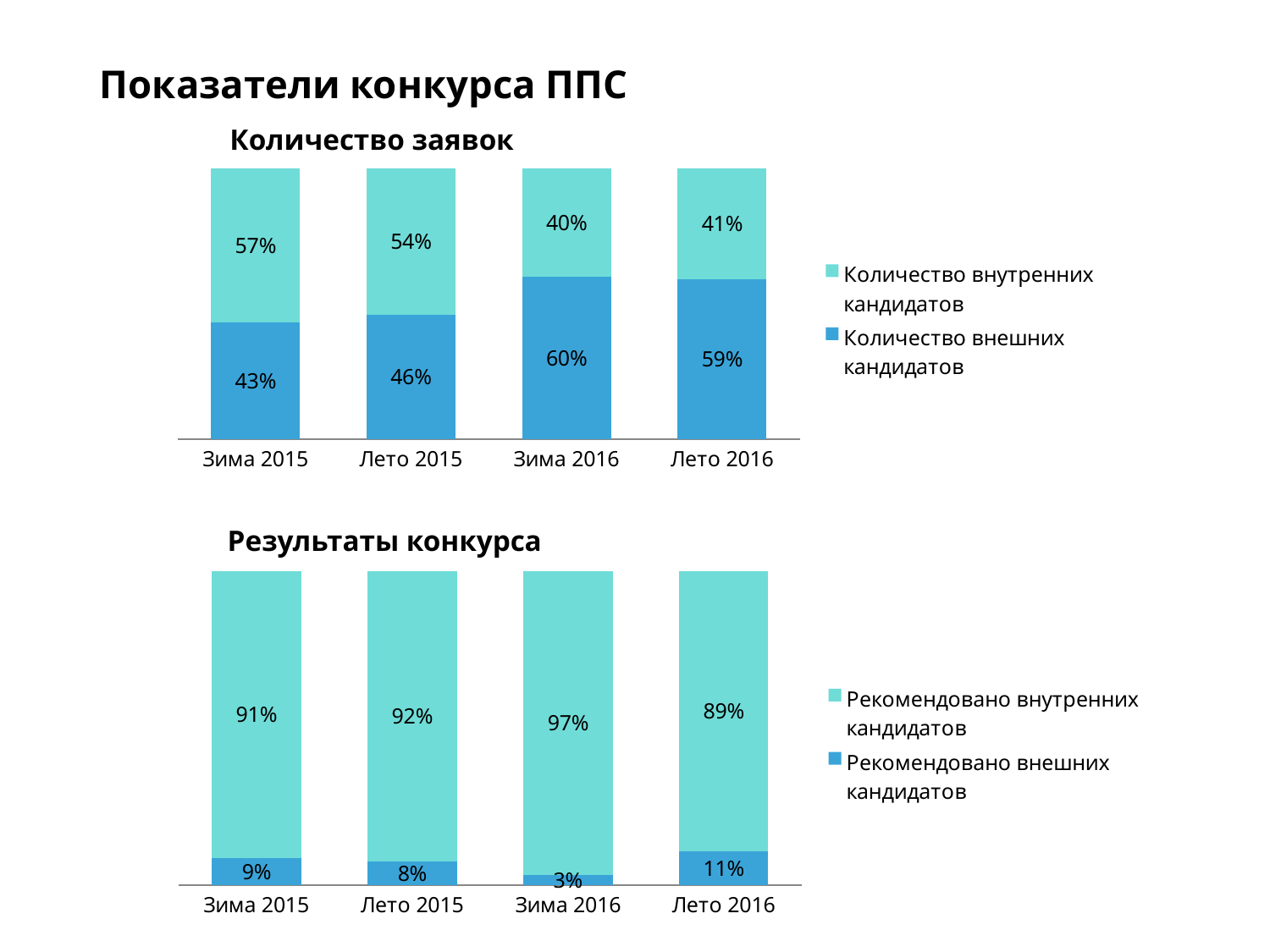
In the 'Количество заявок' chart, what is the value for 'Количество внутренних кандидатов' in Лето 2015? 54% In the 'Количество заявок' chart, what is the difference between 'Количество внешних кандидатов' in Зима 2016 and in Зима 2015? 17% In the 'Результаты конкурса' chart, which is larger: 'Рекомендовано внешних кандидатов' in Лето 2016 or in Зима 2015? Лето 2016 How many series does the legend of the 'Результаты конкурса' chart list? 2 In the 'Количество заявок' chart, what is the total of the stacked bar for Лето 2016? 100% What kind of chart is the 'Результаты конкурса' chart? Stacked bar chart How many categories are shown on the x axis of the 'Количество заявок' chart? 4 In the 'Количество заявок' chart, which category has the highest value for 'Количество внутренних кандидатов'? Зима 2015 In the 'Количество заявок' chart, what is the value for 'Количество внешних кандидатов' in Зима 2016? 60% In the 'Результаты конкурса' chart, what is the difference between 'Рекомендовано внутренних кандидатов' in Зима 2016 and in Лето 2016? 8% In the 'Результаты конкурса' chart, which category has the lowest value for 'Рекомендовано внутренних кандидатов'? Лето 2016 In the 'Результаты конкурса' chart, what is the value for 'Рекомендовано внешних кандидатов' in Зима 2016? 3%